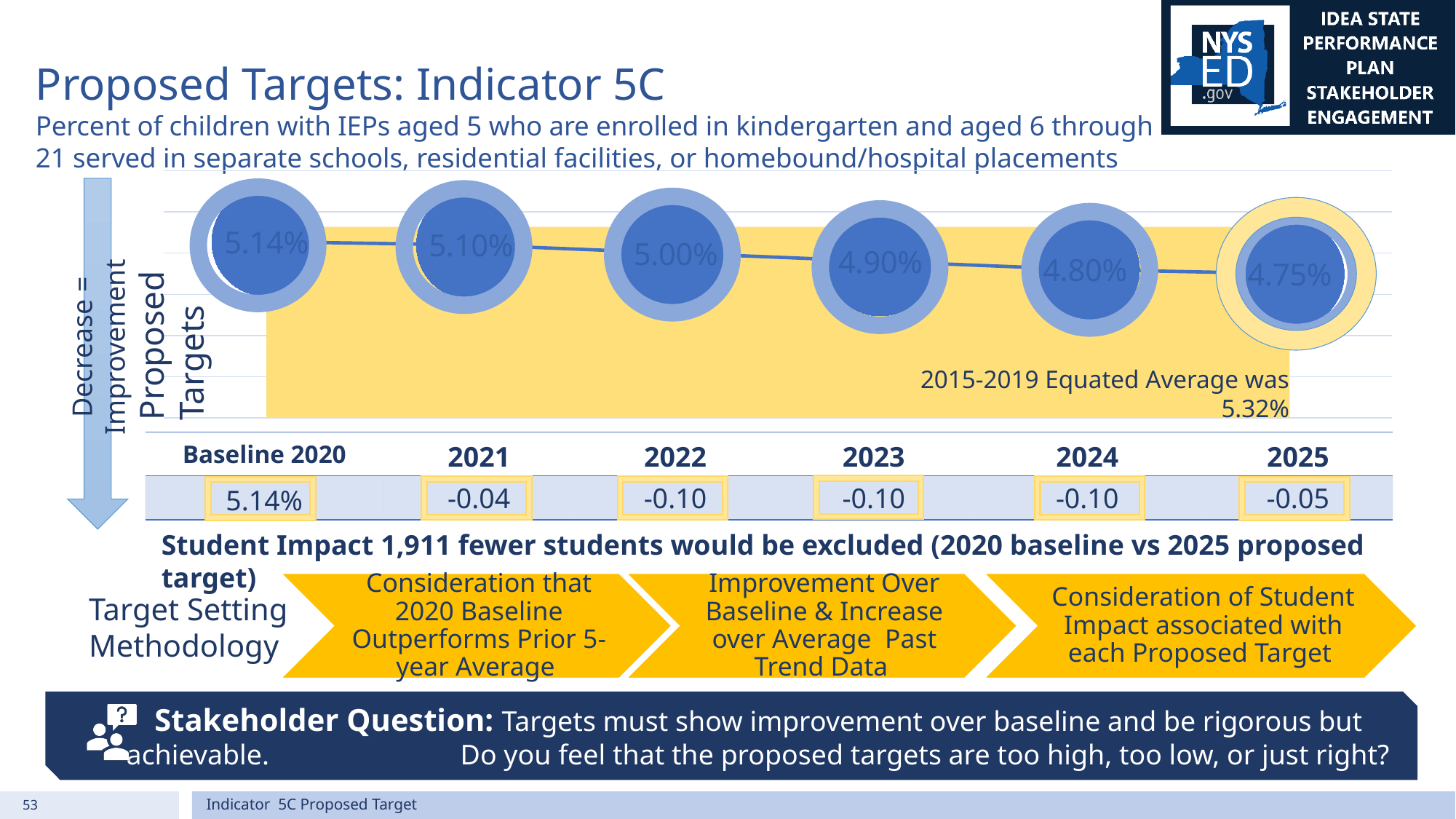
What kind of chart is used to show the proposed targets? line chart Which year has the highest value on the chart? Baseline 2020 Do the proposed target values rise or fall from Baseline 2020 to 2025? fall What is the Baseline 2020 value shown on the chart? 5.14% What was the 2015-2019 Equated Average stated on the chart? 5.32% Which is larger, the value for 2023 or the value for 2024? 2023 What is the proposed target value for 2025? 4.75% What is the difference between the Baseline 2020 value and the 2025 proposed target? 0.39% What is the proposed target value for 2022? 5.00% Which year has the lowest proposed target value? 2025 How many data points are plotted on the chart? 6 What is the year-over-year change shown for 2021 in the row below the chart? -0.04